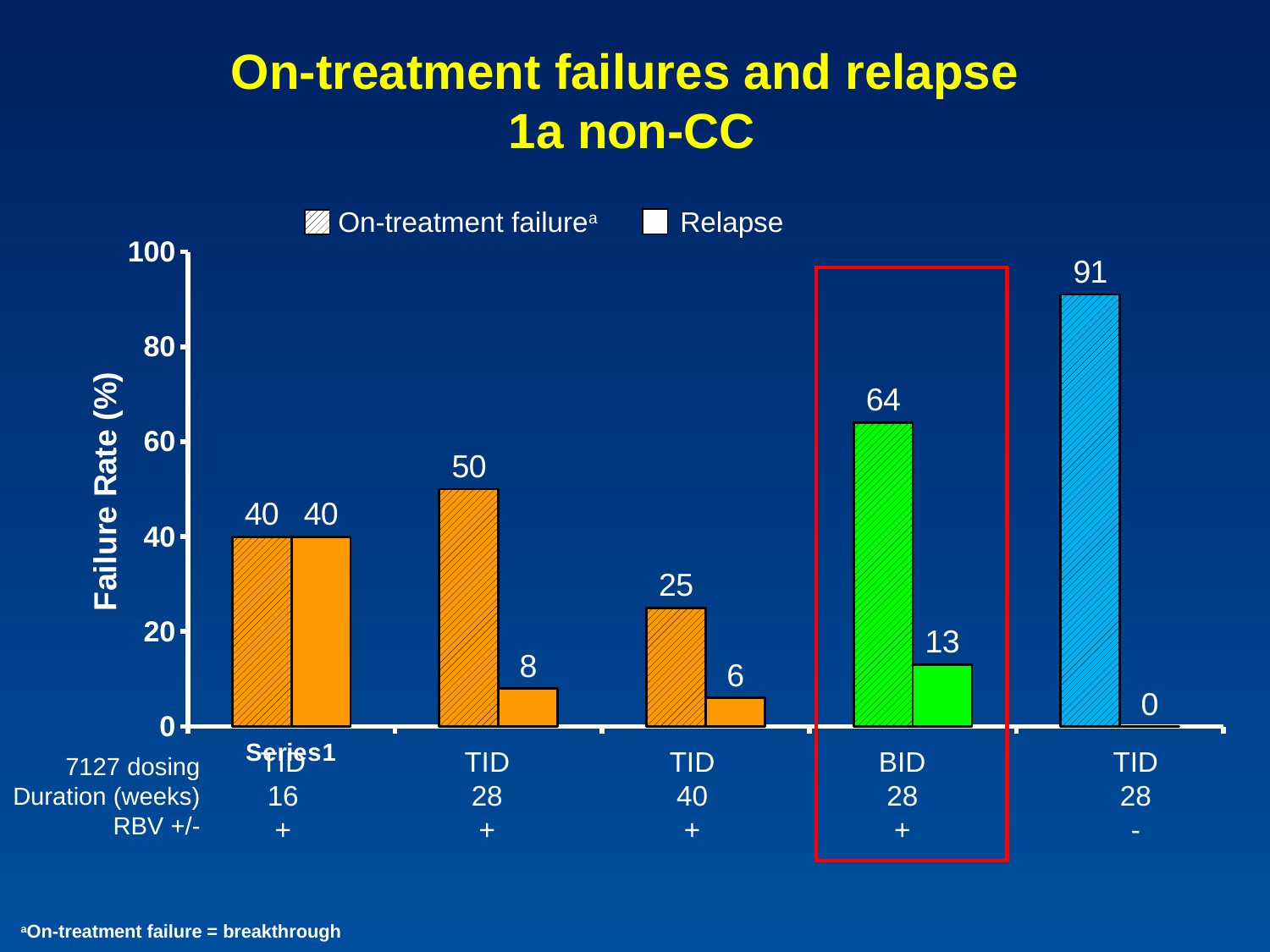
Which is larger for the TID, 40-week, RBV + group: the on-treatment failure rate or the relapse rate? On-treatment failure rate What is the relapse rate for the TID, 28-week, RBV + group? 8 What is the difference between the on-treatment failure rate and the relapse rate for the BID, 28-week, RBV + group? 51 What kind of chart is shown on the slide? Bar chart What is the relapse rate for the TID, 28-week, RBV - group? 0 What is the label of the y axis? Failure Rate (%) Which group has the lowest on-treatment failure rate? TID, 40 weeks, RBV + How many series does the legend list? 2 How many dosing groups are shown on the x axis? 5 Which group has the highest relapse rate? TID, 16 weeks, RBV + What is the on-treatment failure rate for the BID, 28-week, RBV + group? 64 Which group has the highest on-treatment failure rate? TID, 28 weeks, RBV -